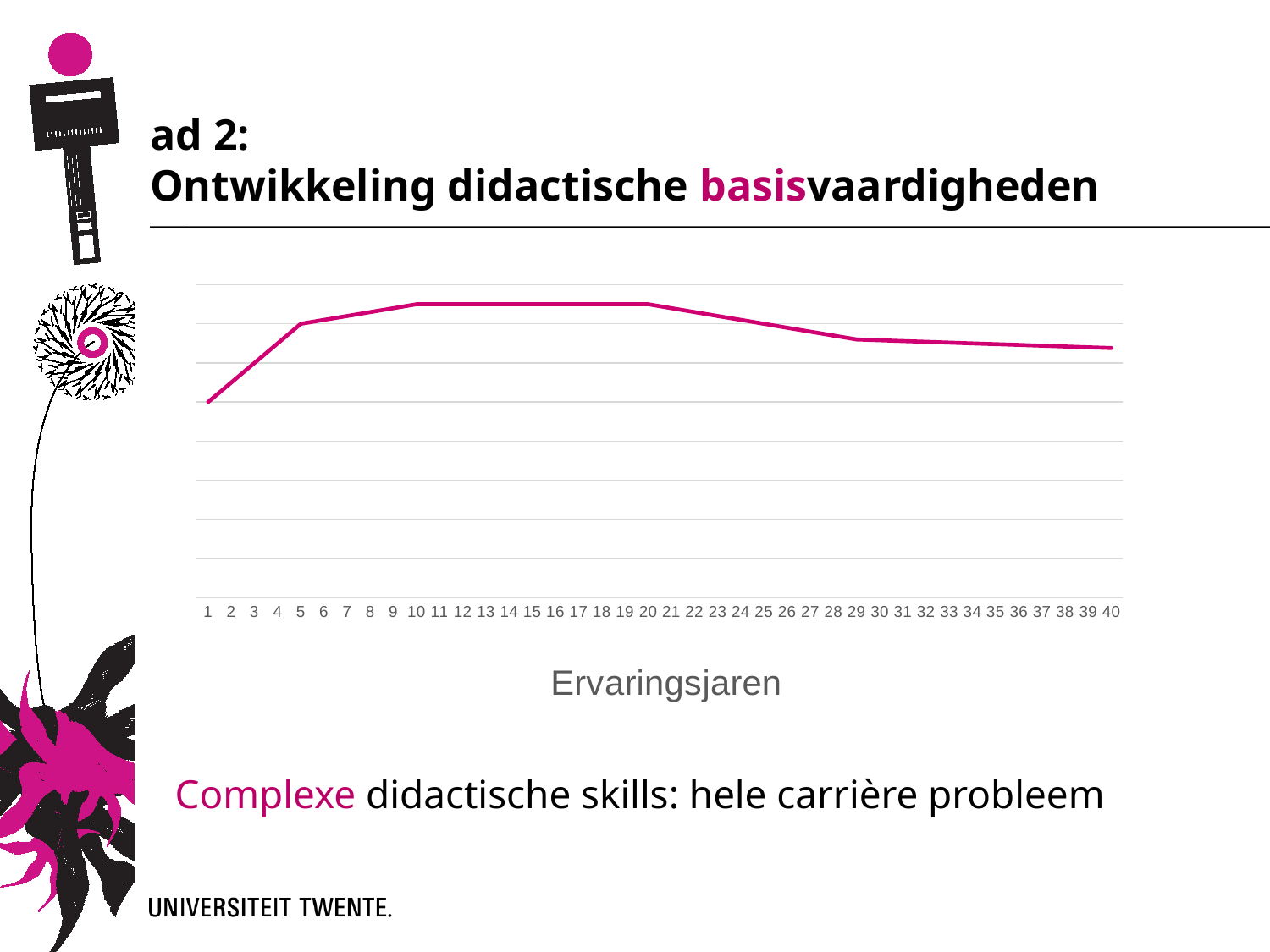
What is the label of the x axis of the chart? Ervaringsjaren Which is higher on the chart, the value at x = 10 or the value at x = 30? x = 10 At which x-axis value is the line at its lowest? 1 Does the line rise or fall between x = 1 and x = 10? rise What colour is the line plotted on the chart? magenta (pink) How many points are marked along the x axis of the chart? 40 Is the line roughly flat or changing between x = 10 and x = 20? flat What kind of chart is shown on the slide? line chart Which is higher on the chart, the value at x = 40 or the value at x = 1? x = 40 Does the line rise or fall between x = 20 and x = 40? fall Which is higher on the chart, the value at x = 1 or the value at x = 20? x = 20